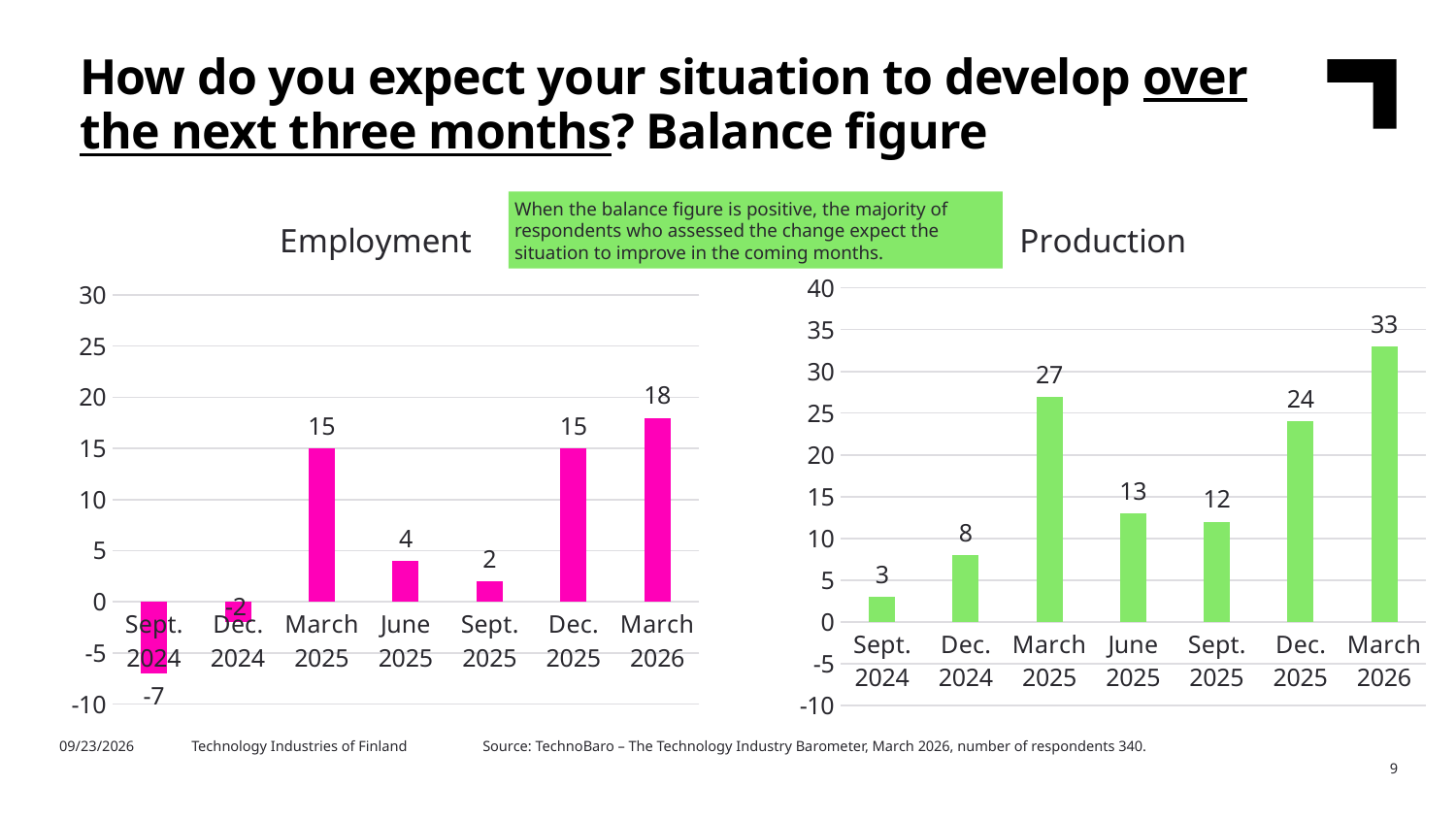
How many periods are shown on the x axis of the Employment chart? 7 In the Employment chart, what is the balance figure for Sept. 2024? -7 In the Production chart, what is the balance figure for Dec. 2025? 24 What colour are the bars in the Employment chart? Pink In the Employment chart, what is the difference between the March 2026 and Dec. 2025 values? 3 In the Employment chart, what is the balance figure for March 2026? 18 In the Production chart, which period has the highest balance figure? March 2026 In the Production chart, which is larger, the value for June 2025 or Sept. 2025? June 2025 In the Production chart, which period has the lowest balance figure? Sept. 2024 In the Production chart, what is the difference between the March 2026 and March 2025 values? 6 In the Employment chart, which period has the lowest balance figure? Sept. 2024 What kind of chart is the Production chart? Bar chart